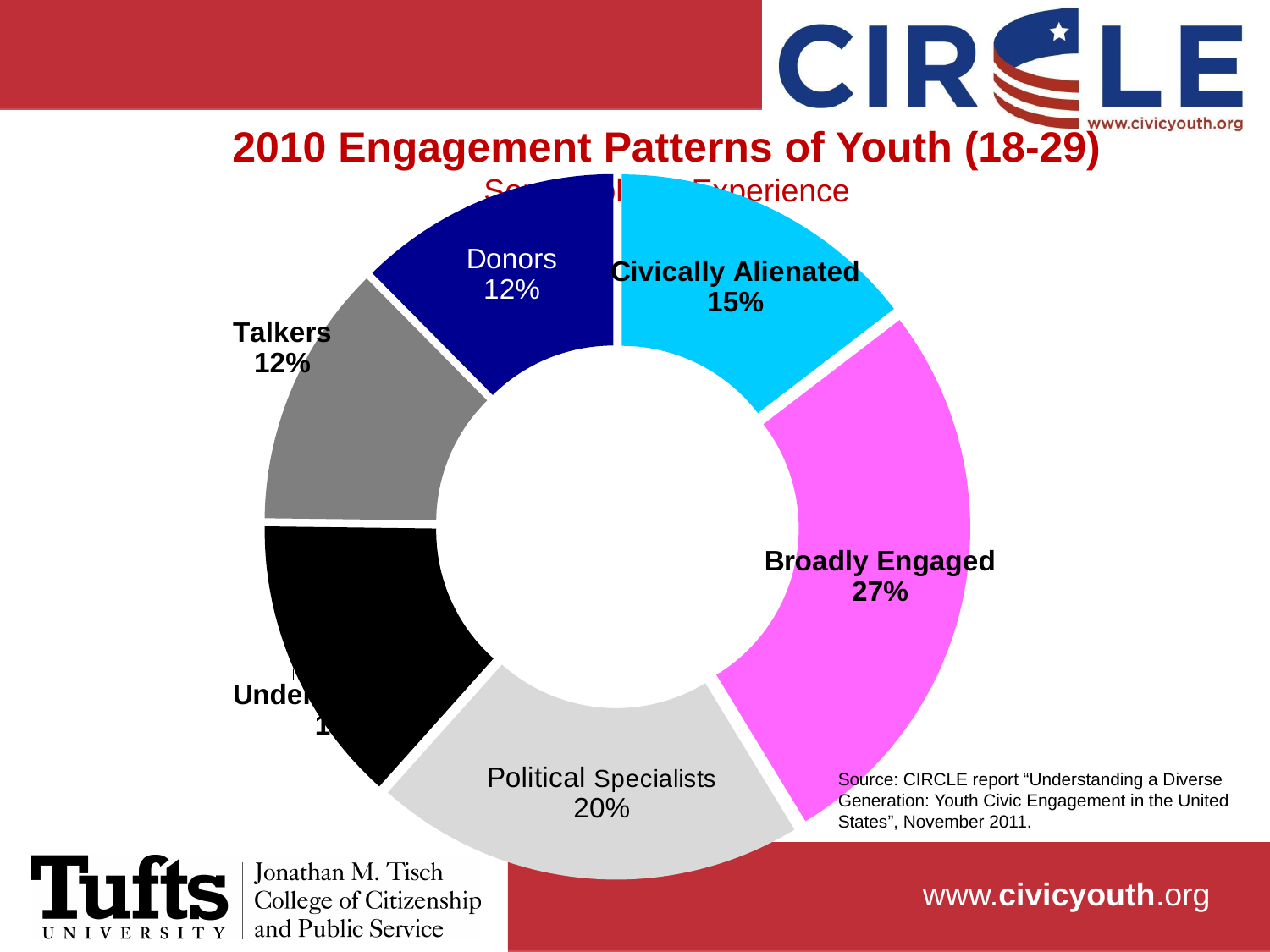
How many percentage points larger is the Broadly Engaged share than the Civically Alienated share? 12 percentage points What percentage is shown for Talkers? 12% How many segments does the chart have? 6 Which is larger, the share for Broadly Engaged or the share for Political Specialists? Broadly Engaged What percentage of youth are Civically Alienated? 15% What type of chart is shown on the slide? Pie chart (donut) What percentage of youth are Broadly Engaged? 27% How many percentage points larger is the Political Specialists share than the Talkers share? 8 percentage points Which is larger, the share for Civically Alienated or the share for Donors? Civically Alienated What share of the chart do Political Specialists make up? 20% Which engagement pattern has the largest share of the chart? Broadly Engaged What percentage is shown for Donors? 12%